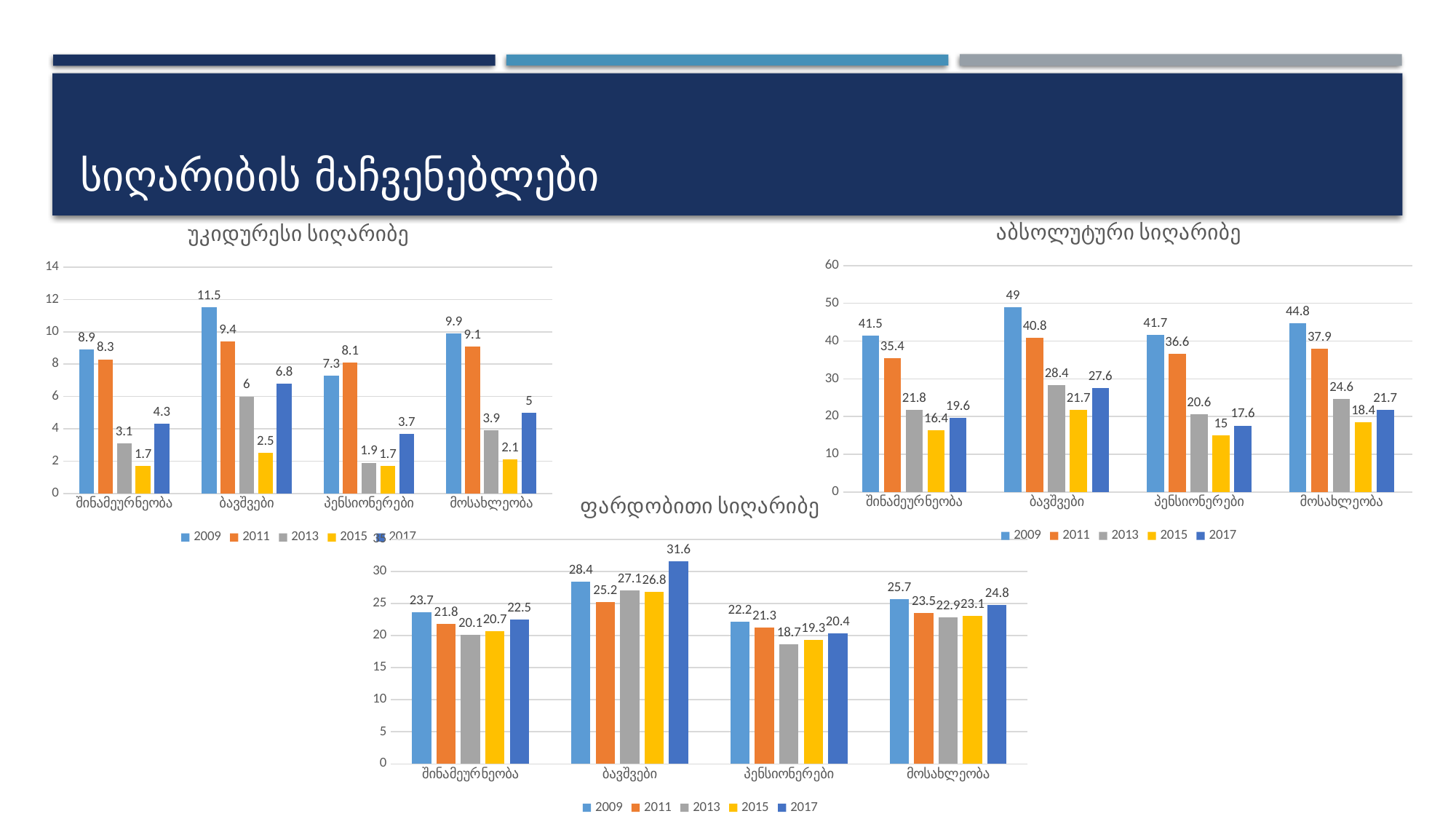
In the chart titled "უკიდურესი სიღარიბე" (top left), how many categories are shown on the x axis? 4 In the chart titled "უკიდურესი სიღარიბე" (top left), what is the value for ბავშვები in 2009? 11.5 In the chart titled "ფარდობითი სიღარიბე" (bottom), what is the value for პენსიონერები in 2013? 18.7 In the chart titled "ფარდობითი სიღარიბე" (bottom), how many series does the legend list? 5 What type of chart is the chart titled "აბსოლუტური სიღარიბე" (top right)? Bar chart In the chart titled "აბსოლუტური სიღარიბე" (top right), which is larger for შინამეურნეობა: the 2013 value or the 2017 value? 2013 In the chart titled "აბსოლუტური სიღარიბე" (top right), which category has the highest value in 2009? ბავშვები In the chart titled "აბსოლუტური სიღარიბე" (top right), what is the value for მოსახლეობა in 2017? 21.7 In the chart titled "ფარდობითი სიღარიბე" (bottom), what is the difference between the 2017 and 2009 values for ბავშვები? 3.2 In the chart titled "აბსოლუტური სიღარიბე" (top right), does the value for პენსიონერები rise or fall from 2009 to 2015? Fall In the chart titled "უკიდურესი სიღარიბე" (top left), which category has the lowest value in 2015? შინამეურნეობა and პენსიონერები (tied at 1.7) How many charts are shown on the slide? 3